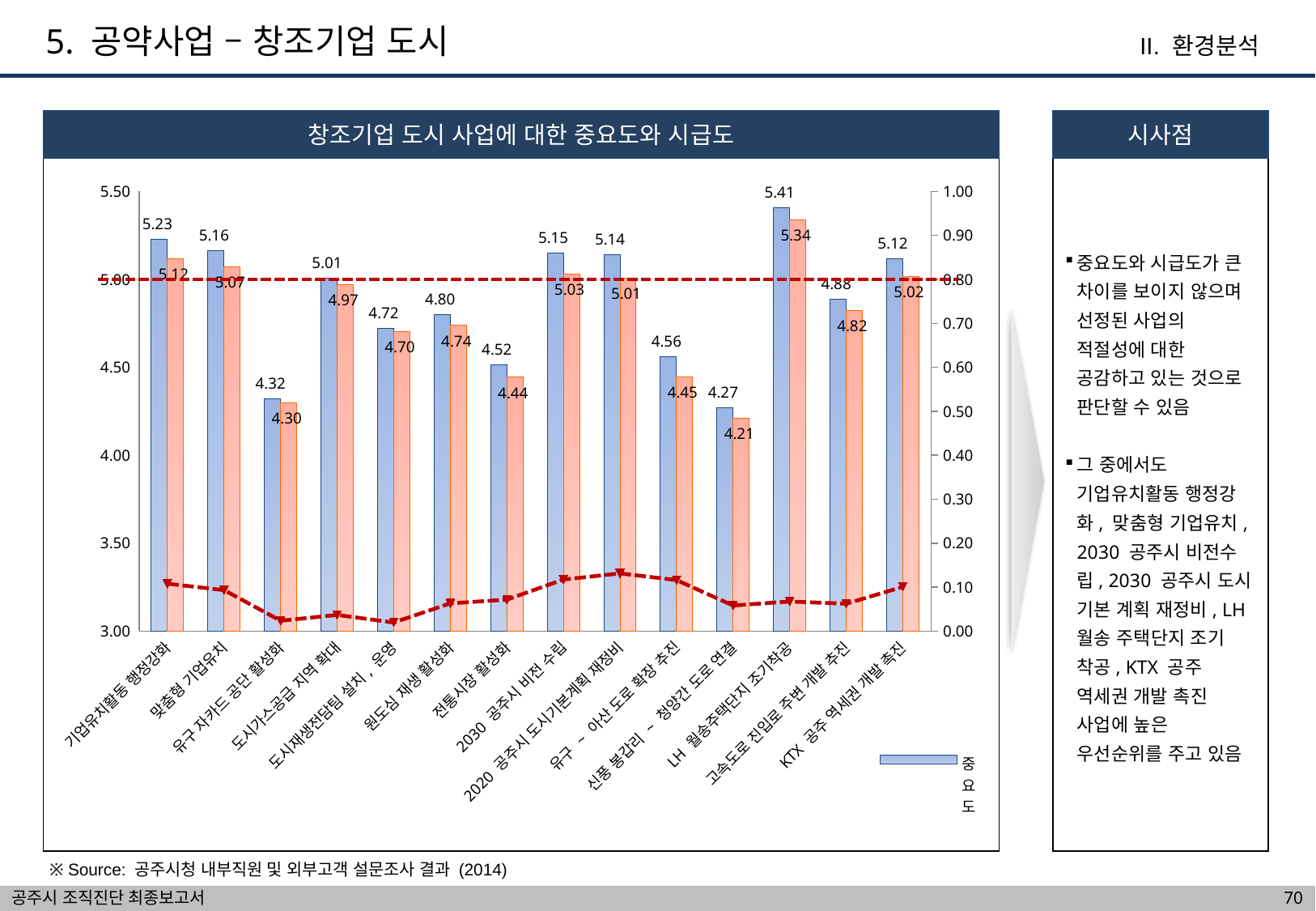
What is the value shown on the orange bar for 유구 자카드 공단 활성화? 4.30 For 기업유치활동 행정강화, what is the difference between the blue bar value and the orange bar value? 0.11 What is the difference between the highest 중요도 value (5.41) and the lowest 중요도 value (4.27)? 1.14 What is the 중요도 value for 2030 공주시 비전 수립? 5.15 Which category has the highest 중요도 value? LH 월송주택단지 조기착공 What is the title of the chart? 창조기업 도시 사업에 대한 중요도와 시급도 Which has a higher 중요도 value: 맞춤형 기업유치 or 전통시장 활성화? 맞춤형 기업유치 How many categories are shown on the x axis of the chart? 14 What is the 중요도 value for LH 월송주택단지 조기착공? 5.41 Which category has the lowest 중요도 value? 신풍 봉갑리 ~ 청양간 도로 연결 Is the 중요도 value for 원도심 재생 활성화 greater or less than 5.00? less What is the 중요도 value for 기업유치활동 행정강화? 5.23